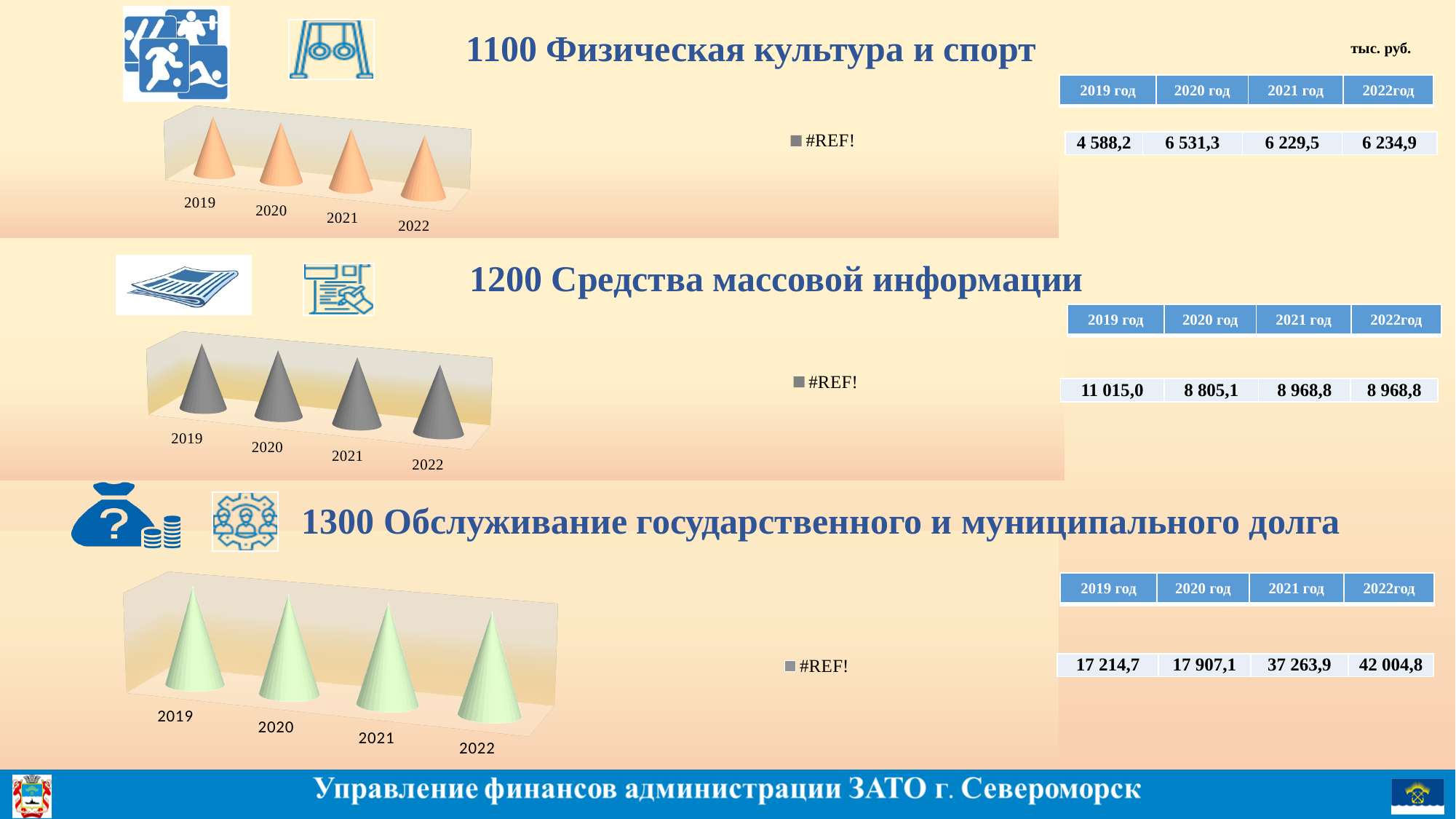
In the table beside the chart under "1300 Обслуживание государственного и муниципального долга", which year has the highest value? 2022год What are the category labels along the x axis of the chart under "1300 Обслуживание государственного и муниципального долга"? 2019, 2020, 2021, 2022 What kind of chart is shown under the heading "1100 Физическая культура и спорт"? bar chart In the table beside the chart under "1200 Средства массовой информации", which year has the lowest value? 2020 год In the table beside the chart under "1100 Физическая культура и спорт", which is larger: the value for 2021 год or the value for 2022год? 2022год In the table beside the chart under "1100 Физическая культура и спорт", what is the value for 2020 год? 6 531,3 In the table beside the chart under "1300 Обслуживание государственного и муниципального долга", what is the value for 2022год? 42 004,8 How many categories are plotted in the chart under "1200 Средства массовой информации"? 4 In the table beside the chart under "1200 Средства массовой информации", what is the value for 2019 год? 11 015,0 How many series does the legend list for the chart under "1300 Обслуживание государственного и муниципального долга"? 1 What is the legend entry shown for the chart under "1100 Физическая культура и спорт"? #REF! In the table beside the chart under "1300 Обслуживание государственного и муниципального долга", what is the difference between the values for 2020 год and 2019 год? 692,4